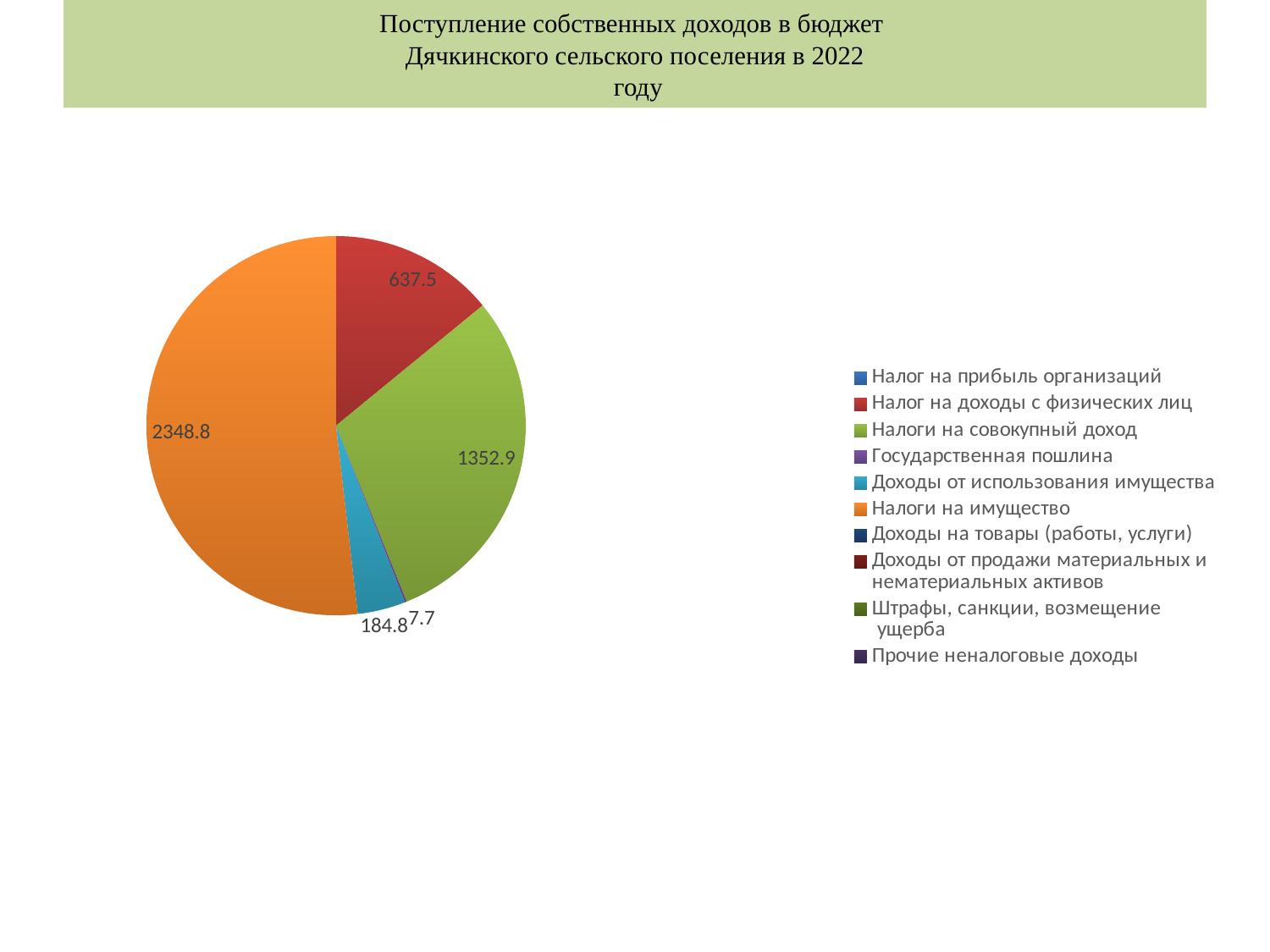
What type of chart is shown on the slide? pie chart What is the value shown for Налоги на имущество? 2348.8 Which category has the largest slice of the pie? Налоги на имущество What is the value shown for Налоги на совокупный доход? 1352.9 What is the difference between the values for Налоги на имущество and Налоги на совокупный доход? 995.9 What is the value shown for Государственная пошлина? 7.7 What colour is the slice for Налоги на имущество? orange How many entries does the legend list? 10 What is the value shown for Налог на доходы с физических лиц? 637.5 What is the difference between the values for Доходы от использования имущества and Государственная пошлина? 177.1 What is the value shown for Доходы от использования имущества? 184.8 Which is larger, Налоги на совокупный доход or Налог на доходы с физических лиц? Налоги на совокупный доход